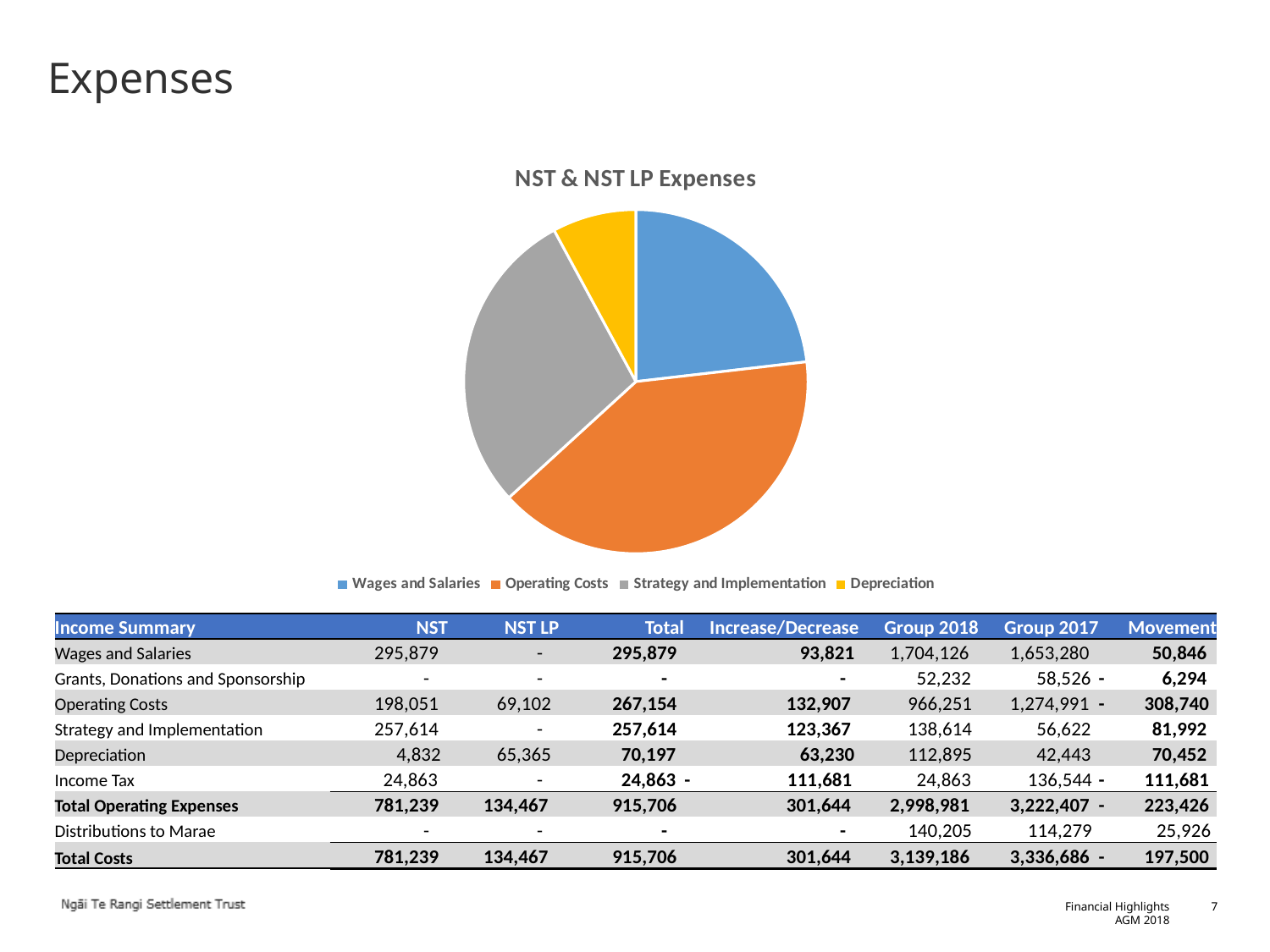
Which category has the smallest slice of the pie chart? Depreciation What kind of chart is shown on the slide? Pie chart Which slice is larger in the pie chart, Operating Costs or Depreciation? Operating Costs Which slice is larger in the pie chart, Strategy and Implementation or Depreciation? Strategy and Implementation What is the title of the chart? NST & NST LP Expenses Which colour represents Strategy and Implementation in the pie chart? Grey How many entries does the chart legend list? 4 Which category has the largest slice of the pie chart? Operating Costs How many slices does the pie chart have? 4 Which slice is larger in the pie chart, Wages and Salaries or Depreciation? Wages and Salaries